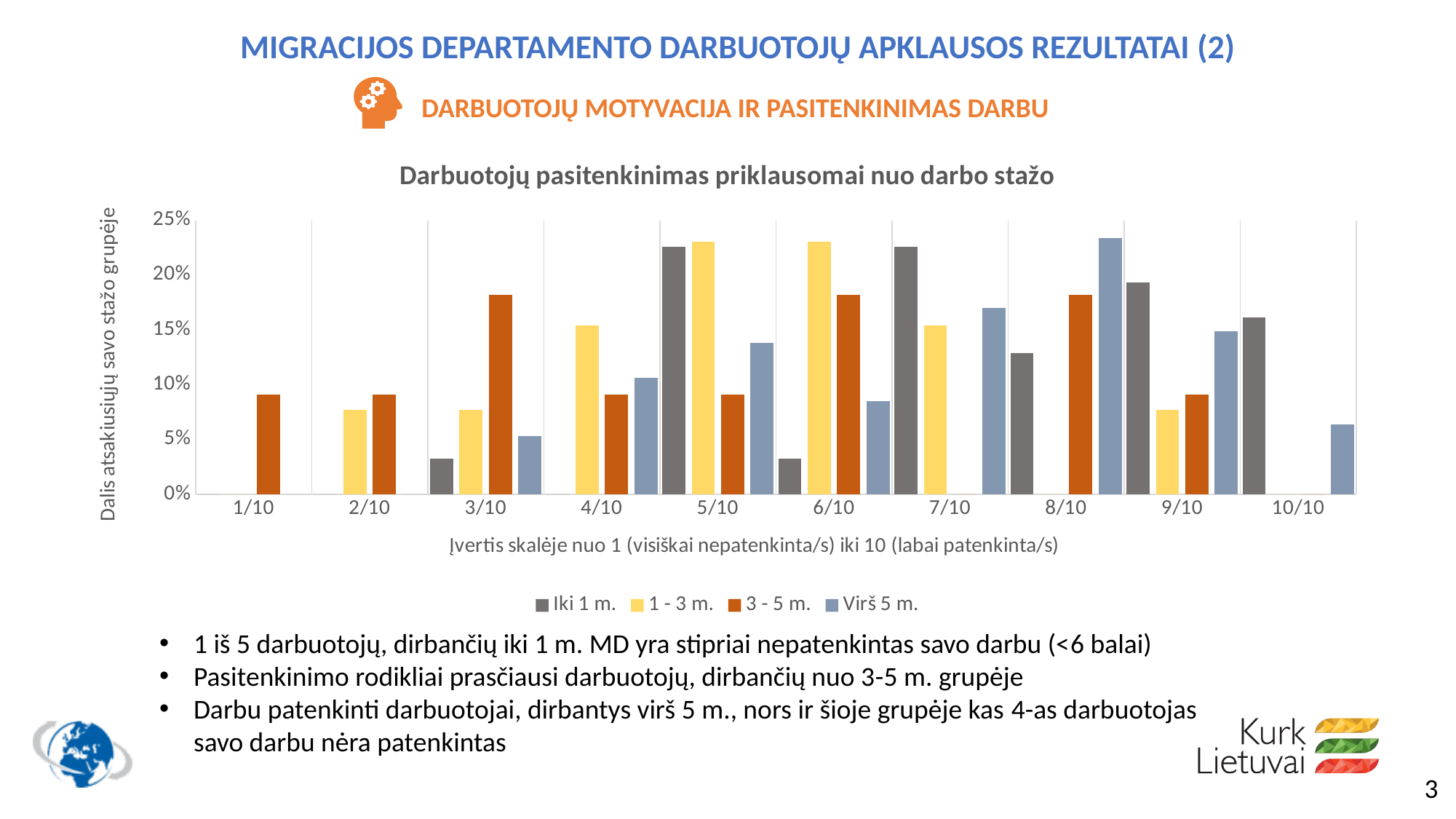
At 7/10, which is larger: the value for 'Iki 1 m.' or for '1 - 3 m.'? Iki 1 m. Is the value for '1 - 3 m.' at 9/10 greater or less than 10%? less At 3/10, which series has the lowest value? Iki 1 m. Is the value for 'Iki 1 m.' at 6/10 greater or less than 5%? less What kind of chart is shown on the slide? bar chart Is the value for '3 - 5 m.' at 3/10 greater or less than 15%? greater What is the title of the chart? Darbuotojų pasitenkinimas priklausomai nuo darbo stažo At 8/10, which series has the highest value? Virš 5 m. How many rating categories are shown along the x axis? 10 For the 'Virš 5 m.' series, at which rating is the value highest? 8/10 How many series does the legend list? 4